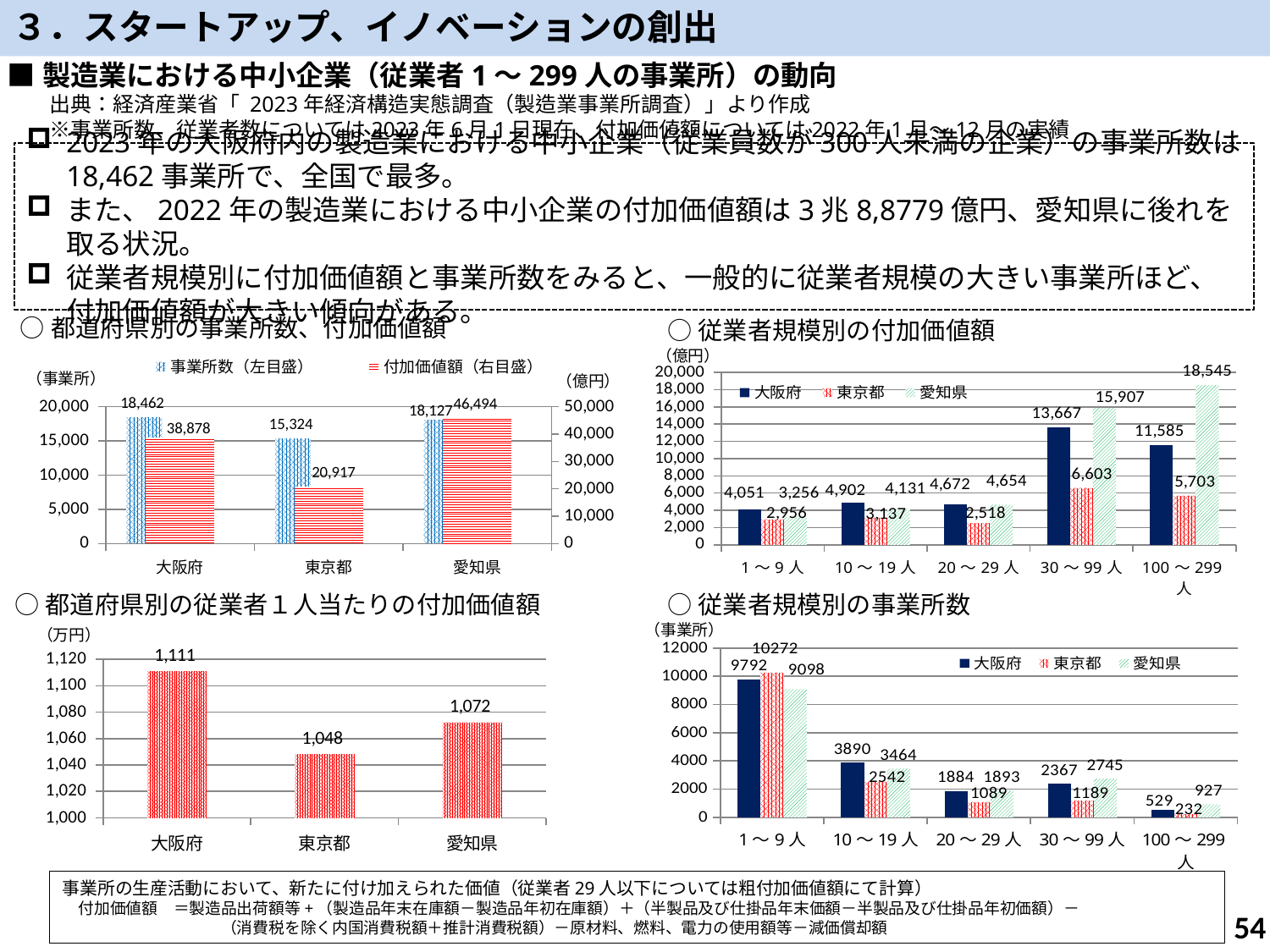
In the chart titled 都道府県別の事業所数、付加価値額, what is the difference between the 付加価値額 of 愛知県 and 東京都? 25,577 In the chart titled 従業者規模別の事業所数, which is larger in the 30～99人 category, 大阪府 or 愛知県? 愛知県 In the chart titled 従業者規模別の付加価値額, what is the value for 愛知県 in the 100～299人 category? 18,545 In the chart titled 従業者規模別の付加価値額, which prefecture has the lowest value in the 30～99人 category? 東京都 In the chart titled 都道府県別の事業所数、付加価値額, which prefecture has the highest 付加価値額? 愛知県 In the chart titled 従業者規模別の付加価値額, how many series does the legend list? 3 In the chart titled 従業者規模別の事業所数, what is the value for 東京都 in the 1～9人 category? 10272 What kind of chart is the one titled 都道府県別の従業者1人当たりの付加価値額? Bar chart In the chart titled 都道府県別の従業者1人当たりの付加価値額, what is the value for 東京都? 1,048 In the chart titled 都道府県別の事業所数、付加価値額, what is the 事業所数 value for 大阪府? 18,462 In the chart titled 都道府県別の従業者1人当たりの付加価値額, which prefecture has the highest value? 大阪府 In the chart titled 従業者規模別の付加価値額, how many employee-size categories are shown on the x axis? 5